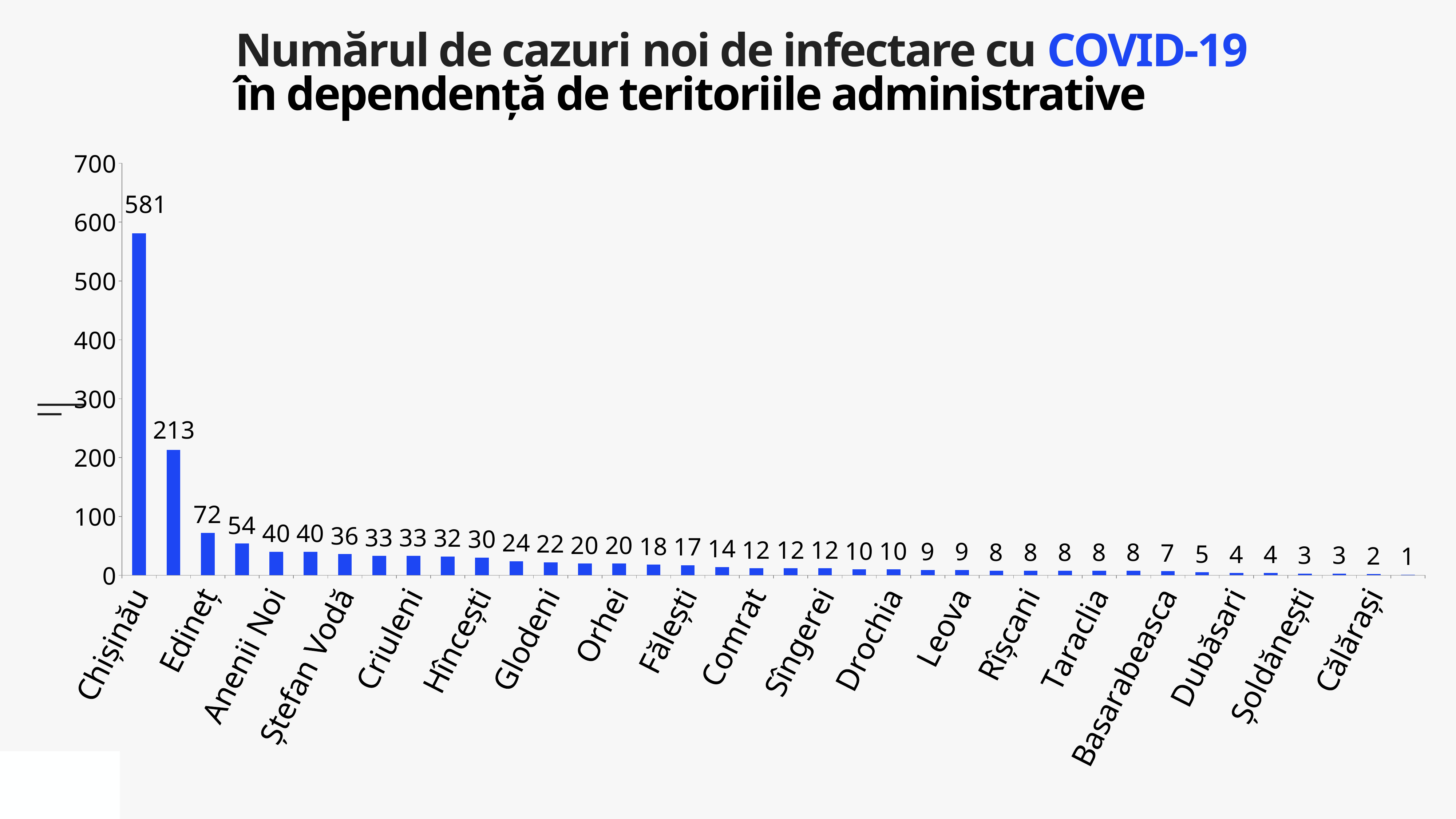
What is the highest value shown on the vertical axis? 700 Is the value for Edineț greater or less than 100? less What is the value for Chișinău? 581 Do the values rise or fall from left to right along the x axis? fall What is the value for Anenii Noi? 40 Is the value for Chișinău greater or less than 500? greater What is the value for Edineț? 72 What is the difference between the values for Chișinău and Edineț? 509 Which territory has the highest number of new cases? Chișinău What kind of chart is shown on the slide? bar chart What is the title of the chart? Numărul de cazuri noi de infectare cu COVID-19 în dependență de teritoriile administrative Which is larger, the value for Chișinău or the value for Edineț? Chișinău